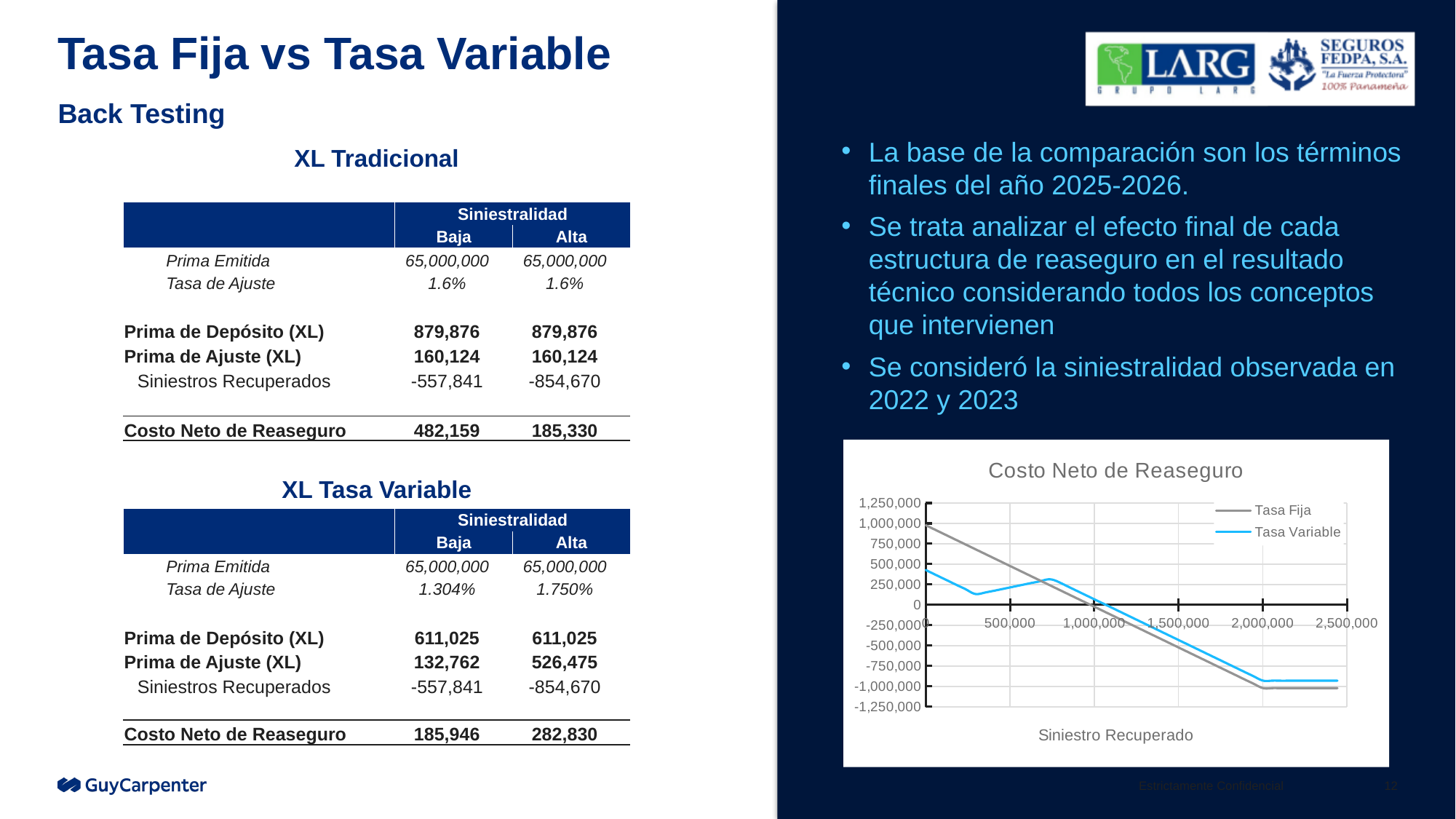
How many series does the legend of the chart list? 2 At Siniestro Recuperado of 0, which series has the higher value, Tasa Fija or Tasa Variable? Tasa Fija At Siniestro Recuperado of 2,500,000, is the value for Tasa Variable greater or less than -500,000? less Does the Tasa Fija line rise or fall as Siniestro Recuperado increases from 0 to 2,000,000? fall At Siniestro Recuperado of 2,500,000, is the value for Tasa Fija greater or less than -750,000? less What kind of chart is shown on the slide? line chart At Siniestro Recuperado of 2,500,000, which series has the higher value, Tasa Fija or Tasa Variable? Tasa Variable At Siniestro Recuperado of 500,000, which series has the higher value, Tasa Fija or Tasa Variable? Tasa Fija At Siniestro Recuperado of 0, is the value for Tasa Variable greater or less than 500,000? less What is the label of the x axis of the chart? Siniestro Recuperado What is the title of the chart? Costo Neto de Reaseguro